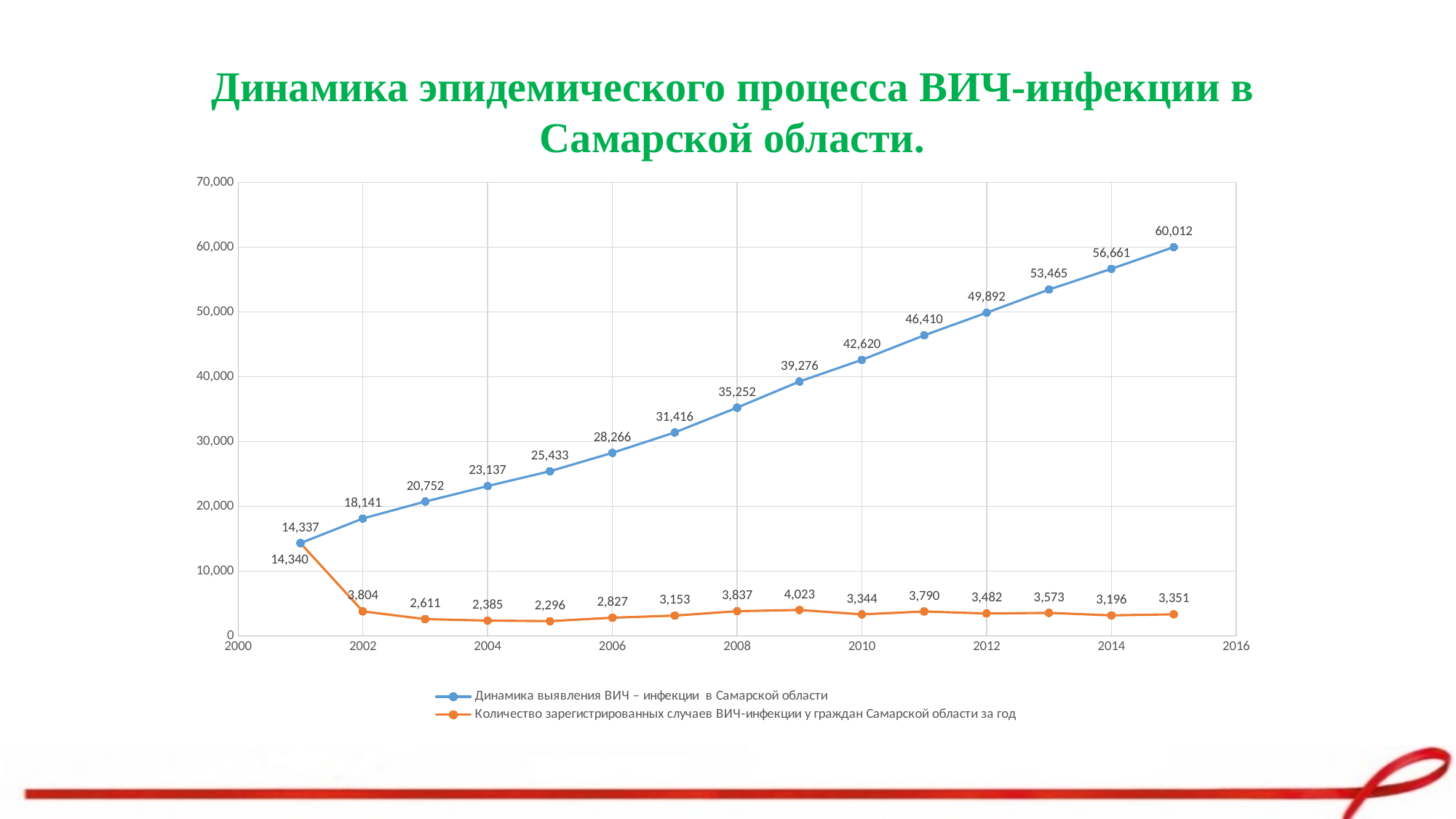
What kind of chart is shown on the slide? Line chart What is the value of the blue series (Динамика выявления ВИЧ-инфекции в Самарской области) in 2015? 60,012 What is the difference between the blue series values in 2015 and 2014? 3,351 What is the difference between the highest and lowest values of the orange series after 2001 (2009 vs 2005)? 1,727 In which year does the orange series (annual registered cases) reach its lowest value? 2005 How many data points does each series have? 15 Which is larger for the orange series: the value in 2011 or the value in 2012? 2011 What is the value of the orange series (Количество зарегистрированных случаев ВИЧ-инфекции у граждан Самарской области за год) in 2009? 4,023 What is the value of the blue series in 2008? 35,252 In which year does the blue series reach its highest value? 2015 How many series does the legend list? 2 Is the value of the blue series in 2010 greater or less than 40,000? greater